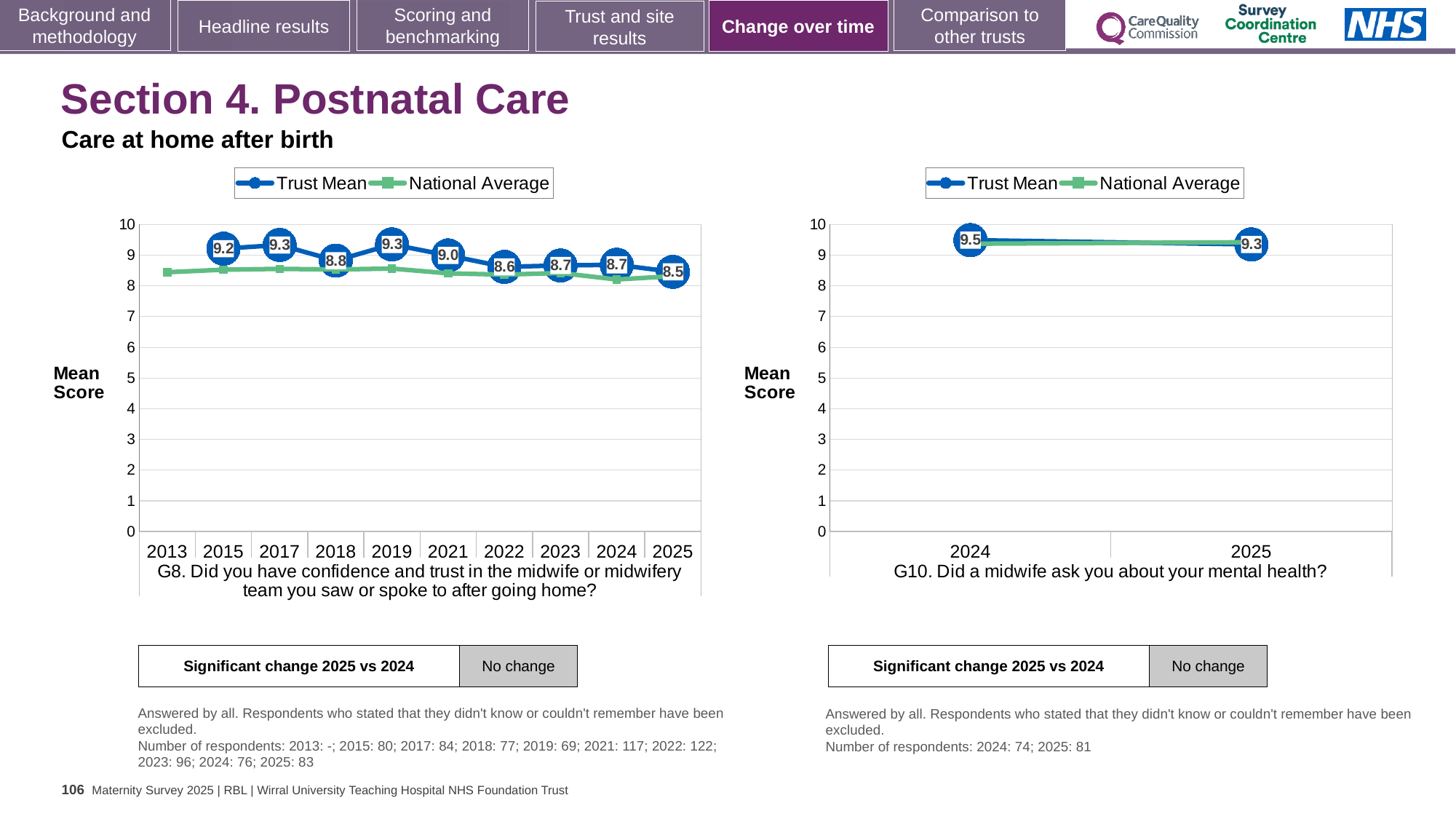
In the G8 chart on the left, what is the difference between the Trust Mean in 2015 and in 2025? 0.7 In the G8 chart on the left, which year has the higher Trust Mean, 2021 or 2022? 2021 In the G10 chart on the right, what is the difference between the Trust Mean in 2024 and in 2025? 0.2 In the G8 chart on the left, is the National Average for 2013 greater or less than 9? less What kind of chart is the G10 chart on the right? Line chart In the G8 chart on the left, what is the Trust Mean for 2025? 8.5 In the G8 chart on the left, what is the Trust Mean for 2018? 8.8 In the G10 chart on the right, what is the Trust Mean for 2024? 9.5 How many years are shown on the x axis of the G8 chart on the left? 10 In the G8 chart on the left, which year has the lowest Trust Mean? 2025 In the G10 chart on the right, does the Trust Mean rise or fall from 2024 to 2025? Fall How many series does the legend of the G10 chart on the right list? 2